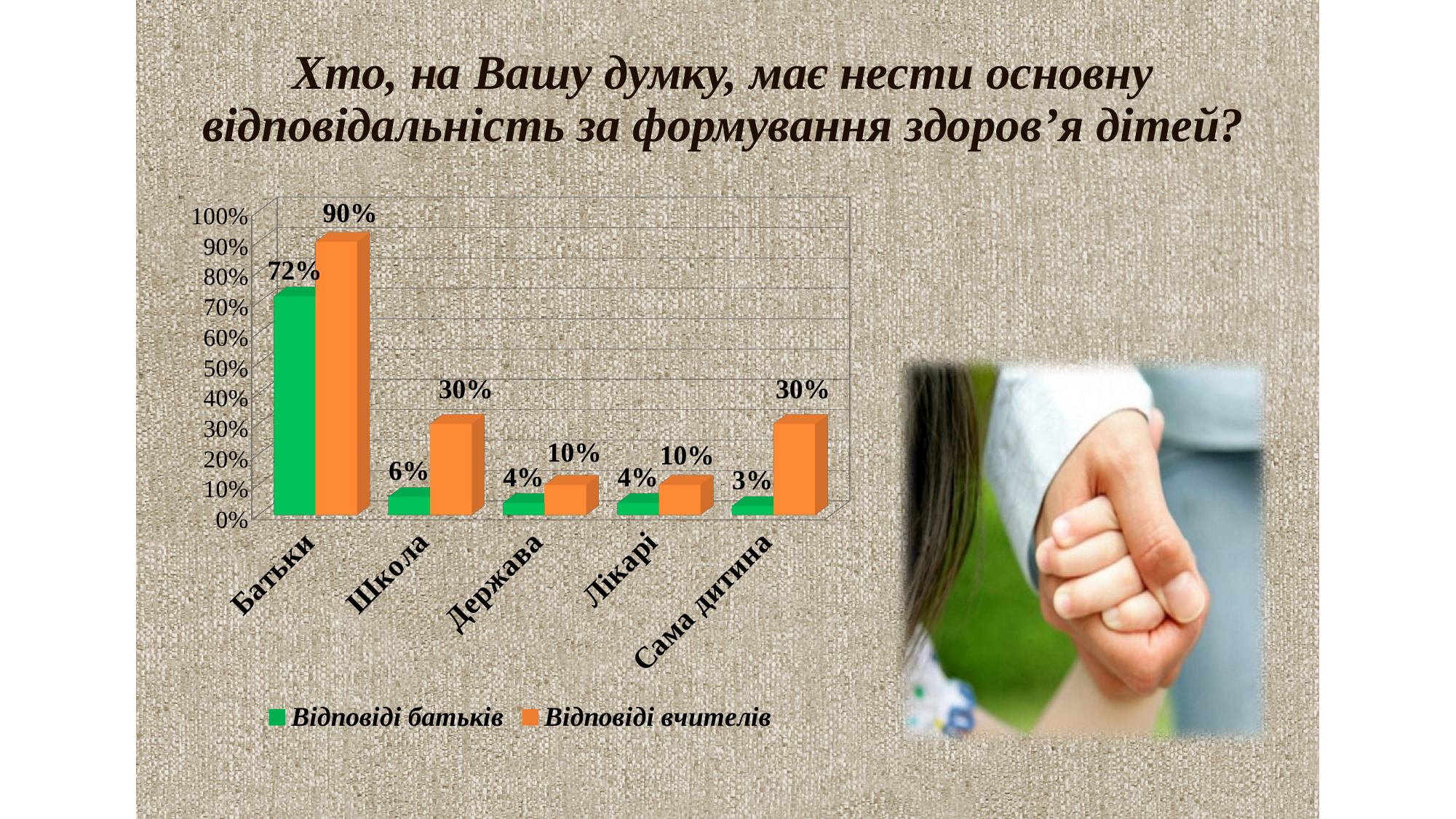
What value is shown for Сама дитина in the Відповіді батьків series? 3% Which category has the lowest value in the Відповіді батьків series? Сама дитина How many categories are shown on the x axis? 5 What is the difference between the Відповіді вчителів and Відповіді батьків values for Батьки? 18% How many series does the legend list? 2 What value is shown for Батьки in the Відповіді вчителів series? 90% What colour represents the Відповіді вчителів series? Orange What value is shown for Школа in the Відповіді вчителів series? 30% What value is shown for Батьки in the Відповіді батьків series? 72% Which is larger for Школа: the Відповіді батьків value or the Відповіді вчителів value? Відповіді вчителів What kind of chart is shown on the slide? Bar chart Which category has the highest value in the Відповіді вчителів series? Батьки